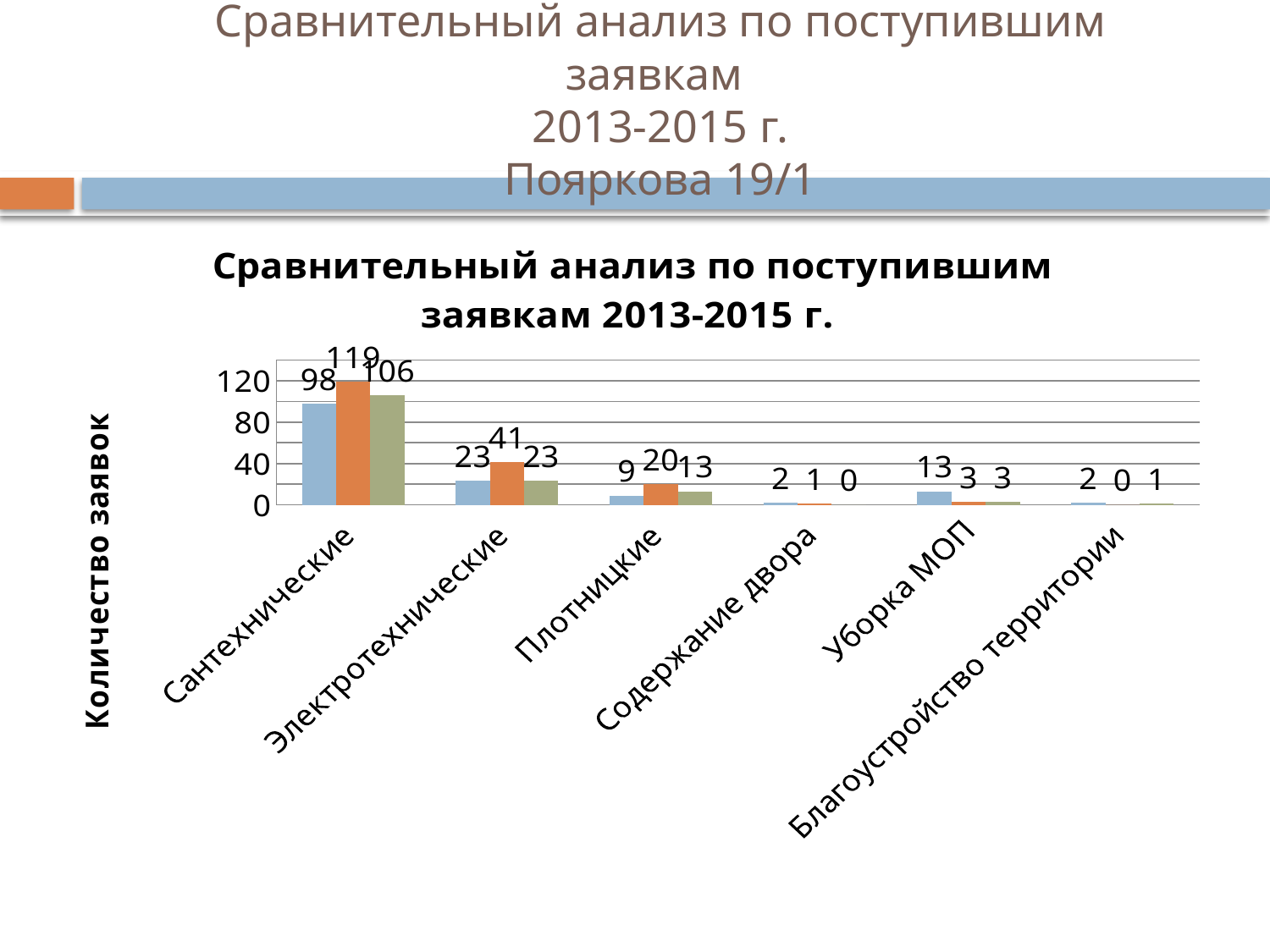
What type of chart is shown? bar chart What is the value of the blue bar for Электротехнические? 23 What is the value of the blue bar for Уборка МОП? 13 How many categories are shown on the x axis? 6 What is the difference between the orange and green bars for Электротехнические? 18 For Плотницкие, which is larger: the orange bar or the blue bar? the orange bar What is the value of the green bar for Плотницкие? 13 What is the label of the vertical axis? Количество заявок What is the difference between the orange and blue bars for Сантехнические? 21 What is the value of the orange bar for Сантехнические? 119 Which category has the highest orange bar? Сантехнические Which category has the lowest blue bar? Содержание двора and Благоустройство территории (both 2)